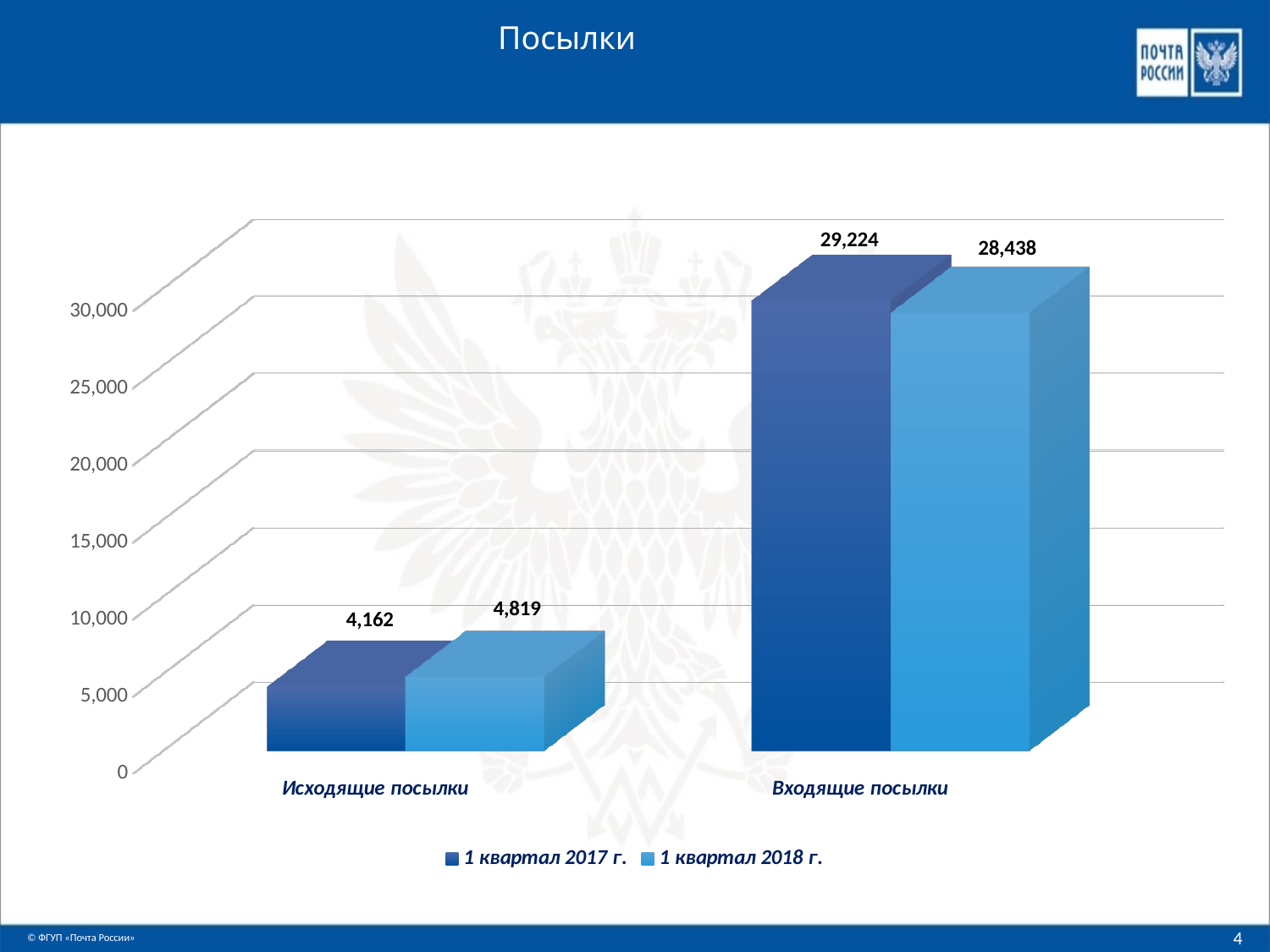
What is the difference between the 1 квартал 2017 г. and 1 квартал 2018 г. values for Входящие посылки? 786 What is the value for Входящие посылки in 1 квартал 2018 г.? 28,438 What kind of chart is shown on the slide? Bar chart Which category has the highest value in 1 квартал 2018 г.? Входящие посылки Which category has the lowest value in 1 квартал 2017 г.? Исходящие посылки What is the value for Входящие посылки in 1 квартал 2017 г.? 29,224 What is the value for Исходящие посылки in 1 квартал 2017 г.? 4,162 What is the difference between the 1 квартал 2018 г. and 1 квартал 2017 г. values for Исходящие посылки? 657 How many series does the legend list? 2 What is the value for Исходящие посылки in 1 квартал 2018 г.? 4,819 How many categories are shown on the x axis? 2 For Входящие посылки, which is larger: 1 квартал 2017 г. or 1 квартал 2018 г.? 1 квартал 2017 г.